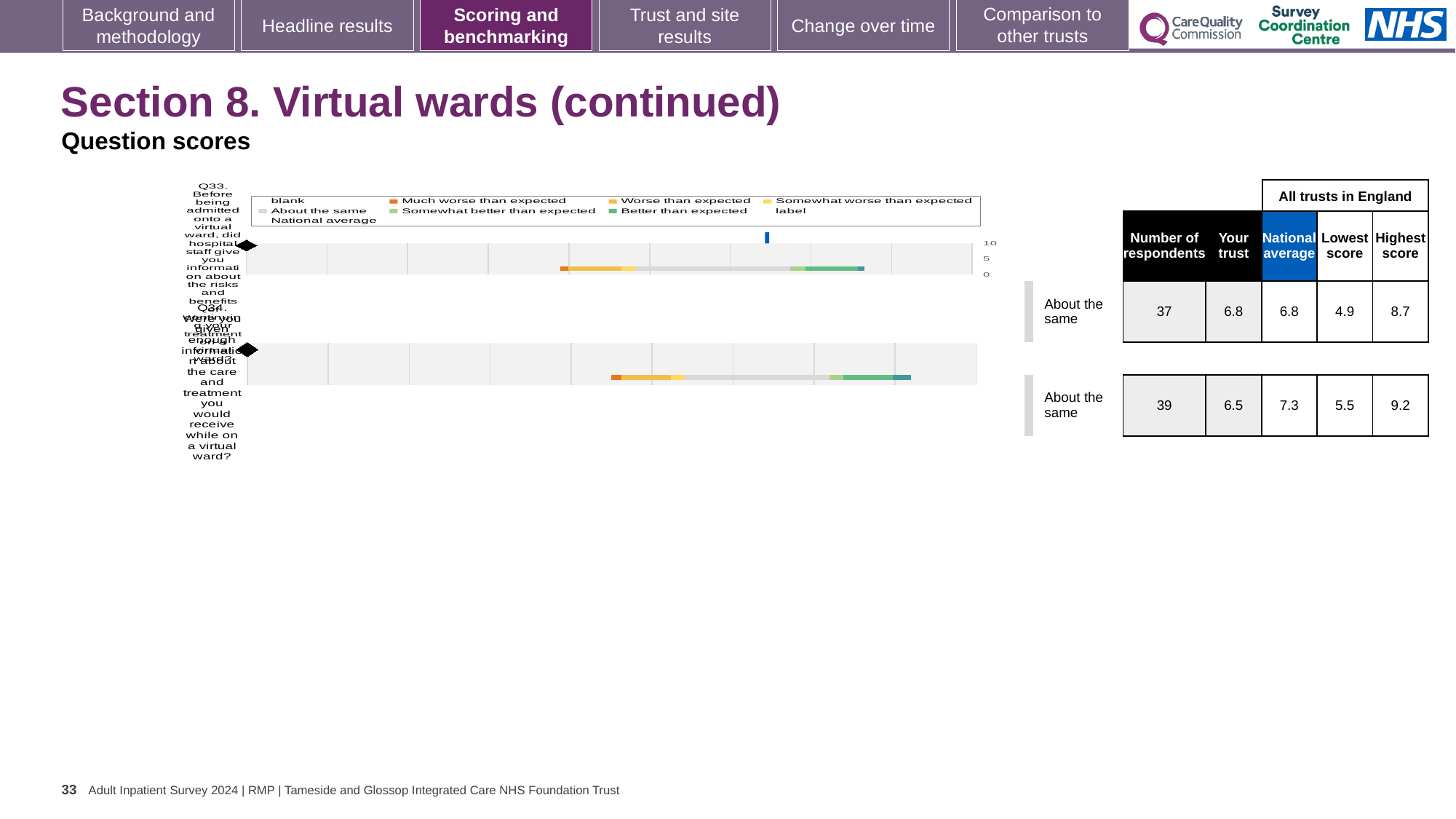
What is the number of respondents for Q33? 37 How many questions (categories) are plotted in the chart? 2 What is the 'Your trust' score for Q34? 6.5 What colour does the legend use for 'Better than expected'? Green For Q34, which is larger: the 'Your trust' score or the national average? National average What benchmark category is shown for Q33? About the same Which question has more respondents, Q33 or Q34? Q34 What is the national average score for Q34? 7.3 What is the highest score among all trusts in England for Q33? 8.7 What is the lowest score among all trusts in England for Q34? 5.5 What kind of chart is shown on the slide? Bar chart What is the difference between the highest score and the lowest score for Q34? 3.7